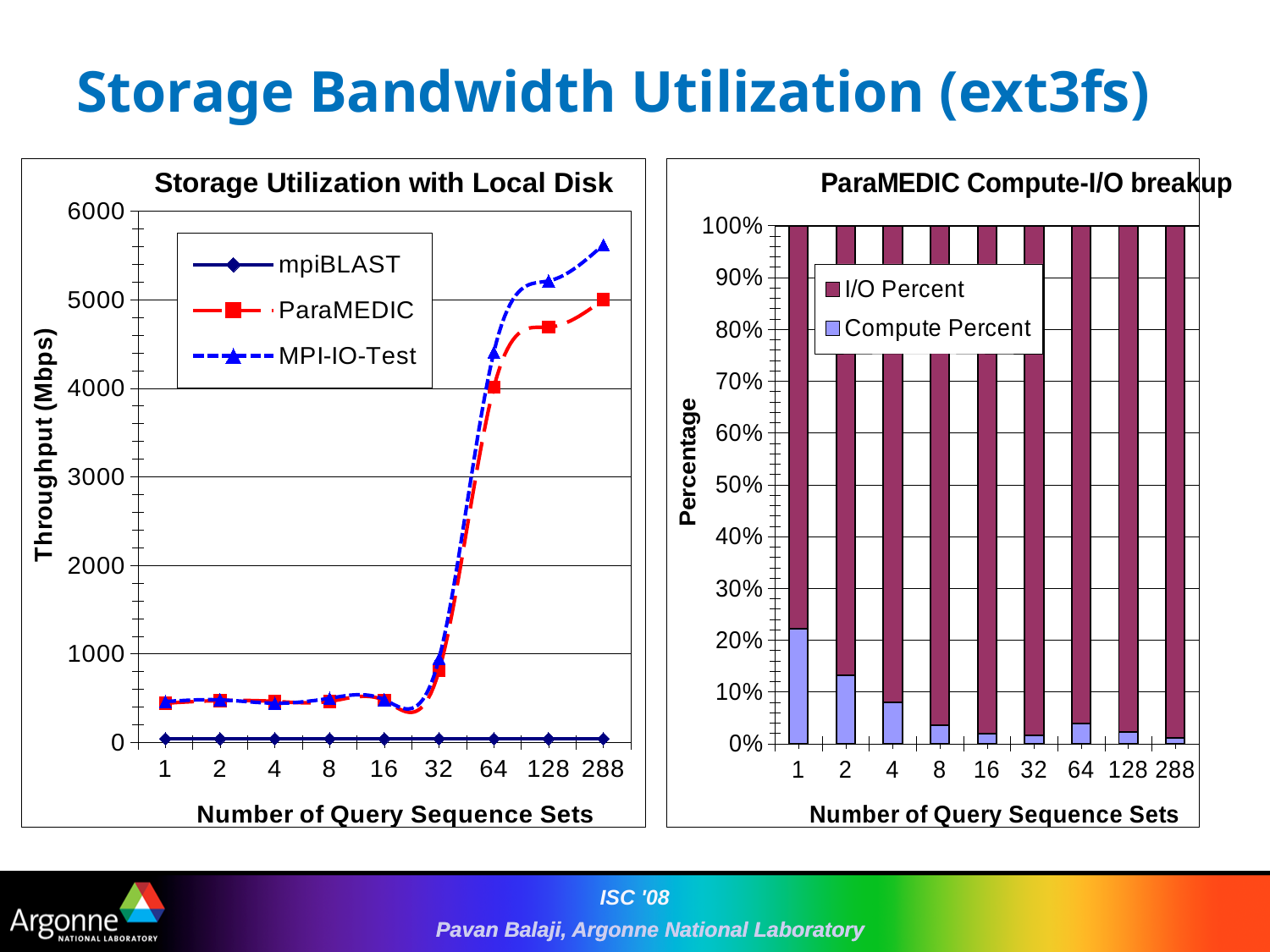
What kind of chart is the 'ParaMEDIC Compute-I/O breakup' chart? bar chart How many categories are shown on the x axis of the 'ParaMEDIC Compute-I/O breakup' chart? 9 In the 'Storage Utilization with Local Disk' chart, is the MPI-IO-Test value at 288 query sequence sets greater or less than 5000? greater In the 'Storage Utilization with Local Disk' chart, does the MPI-IO-Test throughput rise or fall from 32 to 288 query sequence sets? rise What is the y-axis label of the 'Storage Utilization with Local Disk' chart? Throughput (Mbps) In the 'Storage Utilization with Local Disk' chart, which series has the lowest throughput at 288 query sequence sets? mpiBLAST How many series does the legend of the 'ParaMEDIC Compute-I/O breakup' chart list? 2 What kind of chart is the 'Storage Utilization with Local Disk' chart? line chart In the 'ParaMEDIC Compute-I/O breakup' chart, which category has the highest Compute Percent? 1 In the 'Storage Utilization with Local Disk' chart, is the ParaMEDIC value at 64 query sequence sets greater or less than 3000? greater How many series does the legend of the 'Storage Utilization with Local Disk' chart list? 3 In the 'ParaMEDIC Compute-I/O breakup' chart, is the Compute Percent for 1 query sequence set greater or less than 20%? greater